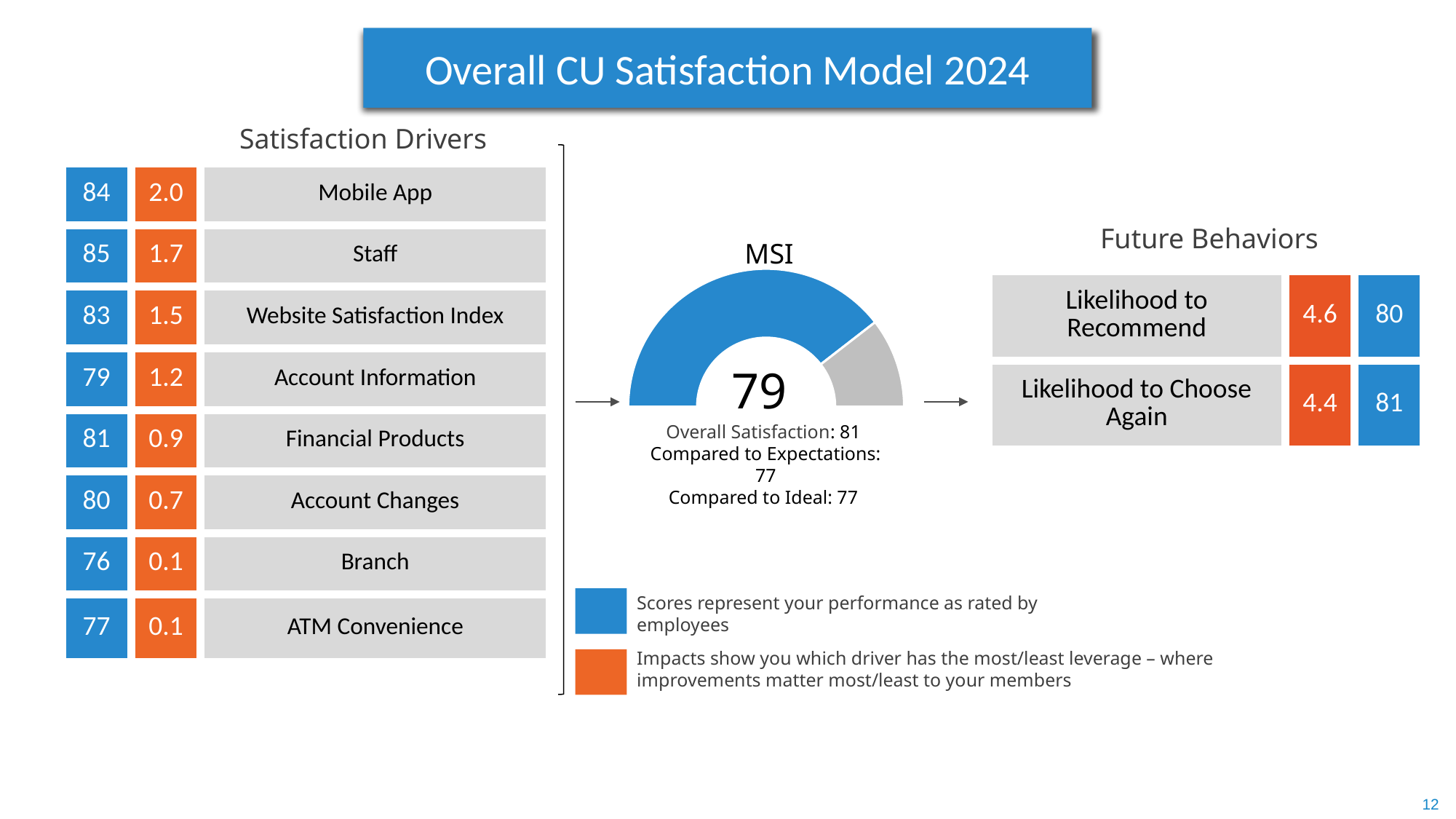
Which is larger, the MSI gauge value or the Overall Satisfaction value printed below it? Overall Satisfaction What value is shown in the center of the MSI gauge chart? 79 What is the Overall Satisfaction value printed below the MSI gauge? 81 What is the difference between the Overall Satisfaction value (81) and the MSI gauge value (79)? 2 Is the MSI gauge value greater or less than 50? greater What kind of chart is the MSI chart? gauge chart What is the Compared to Expectations value printed below the MSI gauge? 77 What is the Compared to Ideal value printed below the MSI gauge? 77 What is the title of the gauge chart in the middle of the slide? MSI Is more than half of the MSI gauge filled in blue? yes What colour is the filled portion of the MSI gauge? blue